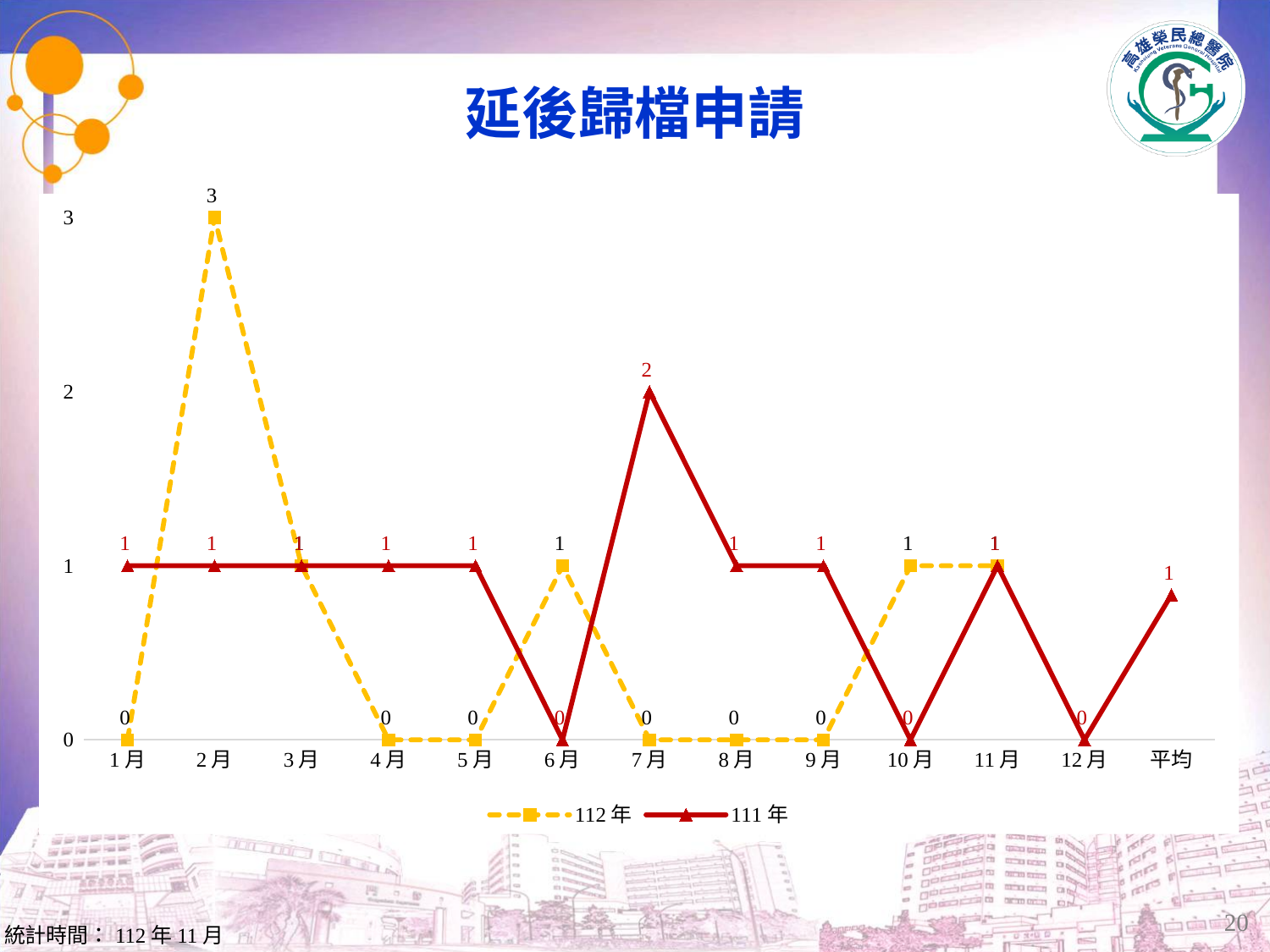
What is the value for 111年 in 7月? 2 In which month does the 111年 series reach its highest value? 7月 How many categories are shown on the x axis? 13 What is the value for 112年 in 10月? 1 What is the value for 111年 in 6月? 0 What is the value for 112年 in 2月? 3 What is the title of the chart? 延後歸檔申請 In 7月, which series has the larger value, 112年 or 111年? 111年 What is the difference between the 112年 and 111年 values in 2月? 2 How many series does the legend list? 2 What kind of chart is shown on the slide? line chart In which month does the 112年 series reach its highest value? 2月